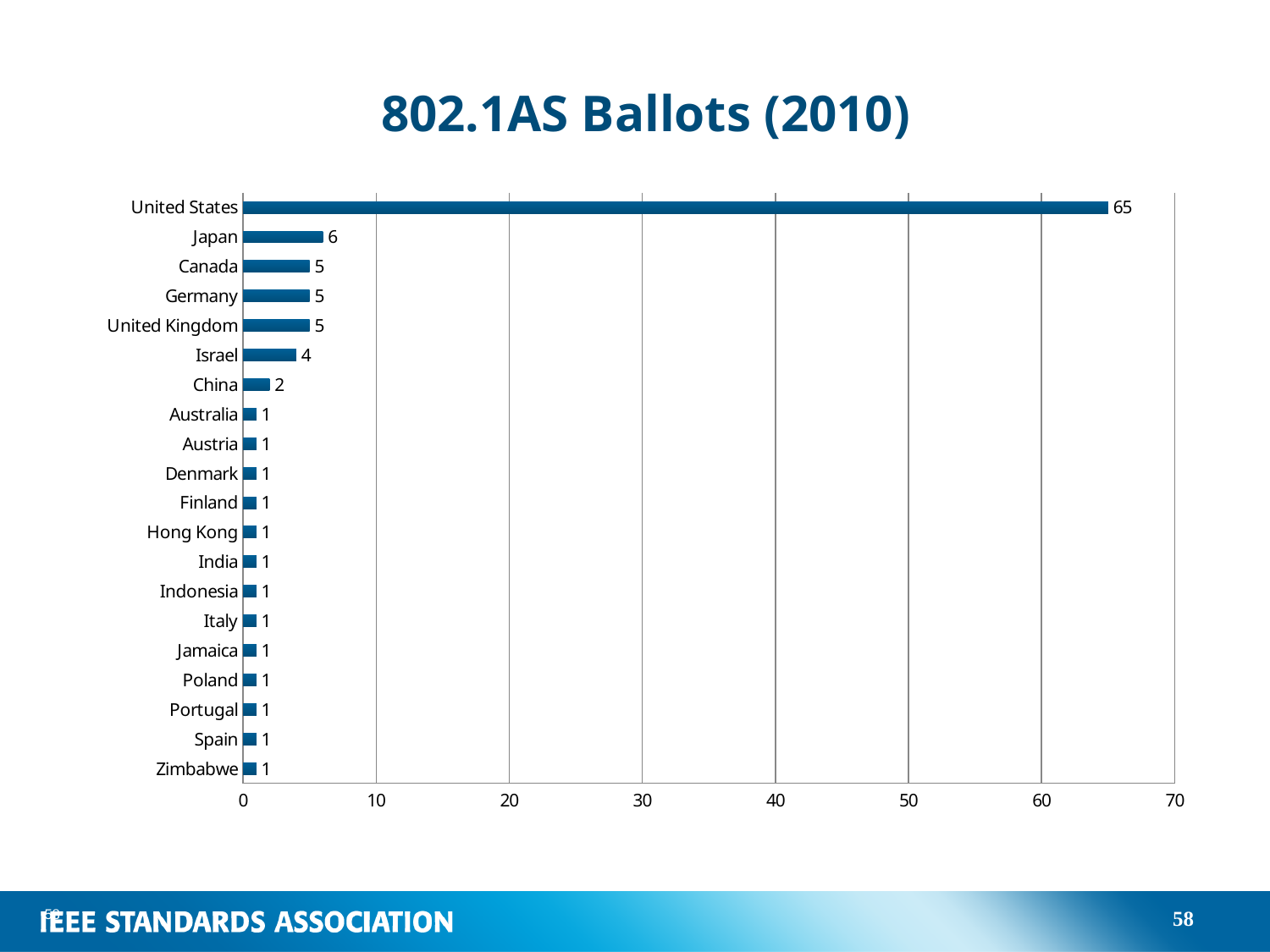
How many countries are shown in the chart? 20 Is the value for United States greater or less than 60? greater What kind of chart is shown on the slide? bar chart What is the title of the chart? 802.1AS Ballots (2010) Which is larger, the value for Israel or the value for China? Israel What is the value for Japan? 6 Which country has the highest value? United States What is the difference between the values for United States and Japan? 59 What is the value for United States? 65 What is the value for Israel? 4 What is the difference between the values for Japan and Israel? 2 What is the value for China? 2